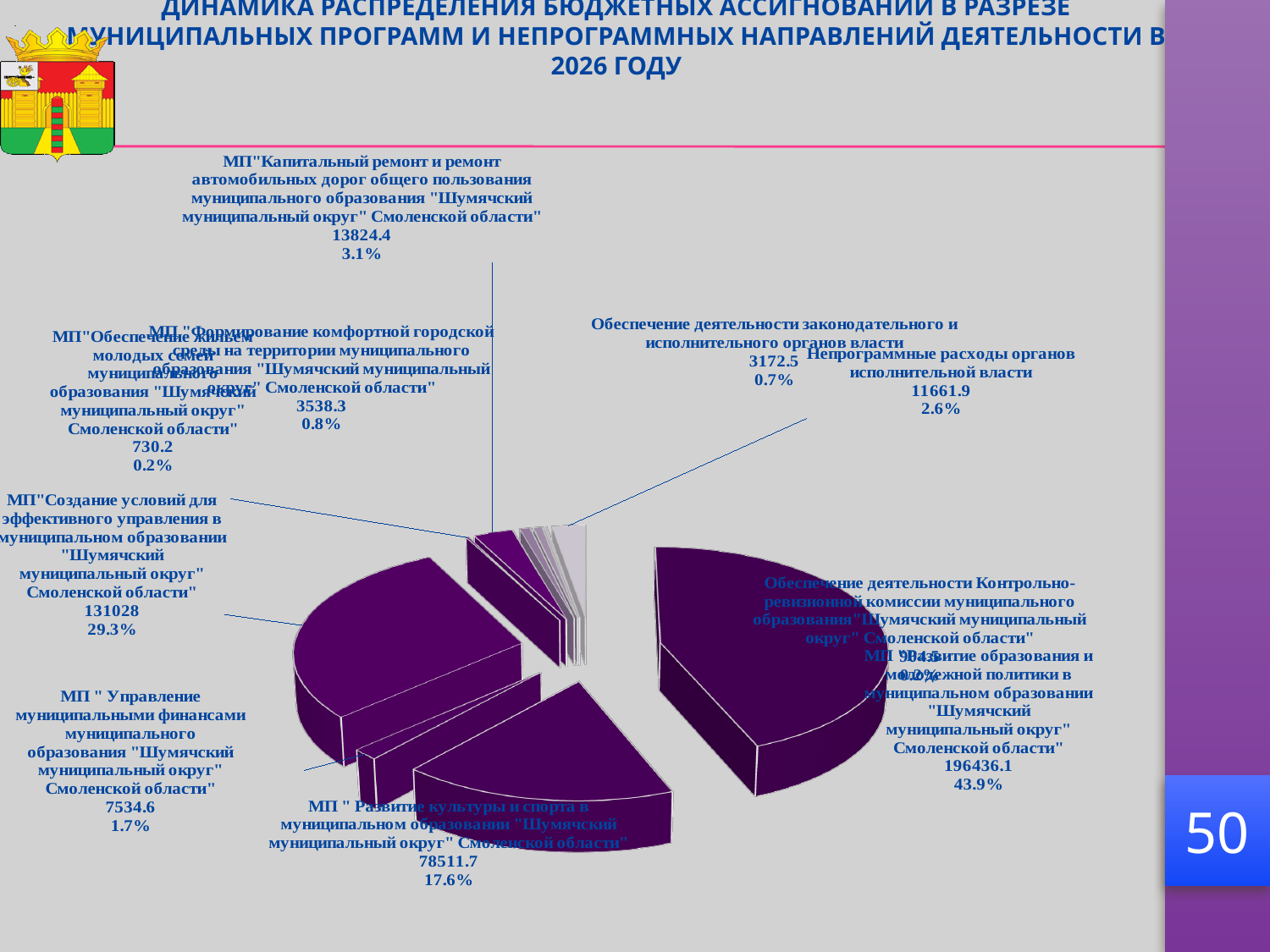
What percentage is shown for Непрограммные расходы органов исполнительной власти? 2.6% What is the value shown for МП "Развитие культуры и спорта"? 78511.7 What is the value shown for МП "Капитальный ремонт и ремонт автомобильных дорог общего пользования"? 13824.4 What is the difference between the values for МП "Развитие образования и молодежной политики" (196436.1) and МП "Развитие культуры и спорта" (78511.7)? 117924.4 Which year does the chart title say the budget allocation distribution refers to? 2026 What is the value shown for МП "Формирование комфортной городской среды"? 3538.3 What share of the pie does МП "Развитие образования и молодежной политики" account for? 43.9% Which category has the largest share of the pie? МП "Развитие образования и молодежной политики" What kind of chart is shown on the slide? pie chart What percentage is shown for Обеспечение деятельности законодательного и исполнительного органов власти? 0.7% Which is larger: the value for МП "Управление муниципальными финансами" or for Непрограммные расходы органов исполнительной власти? Непрограммные расходы органов исполнительной власти What is the value shown for МП "Создание условий для эффективного управления"? 131028